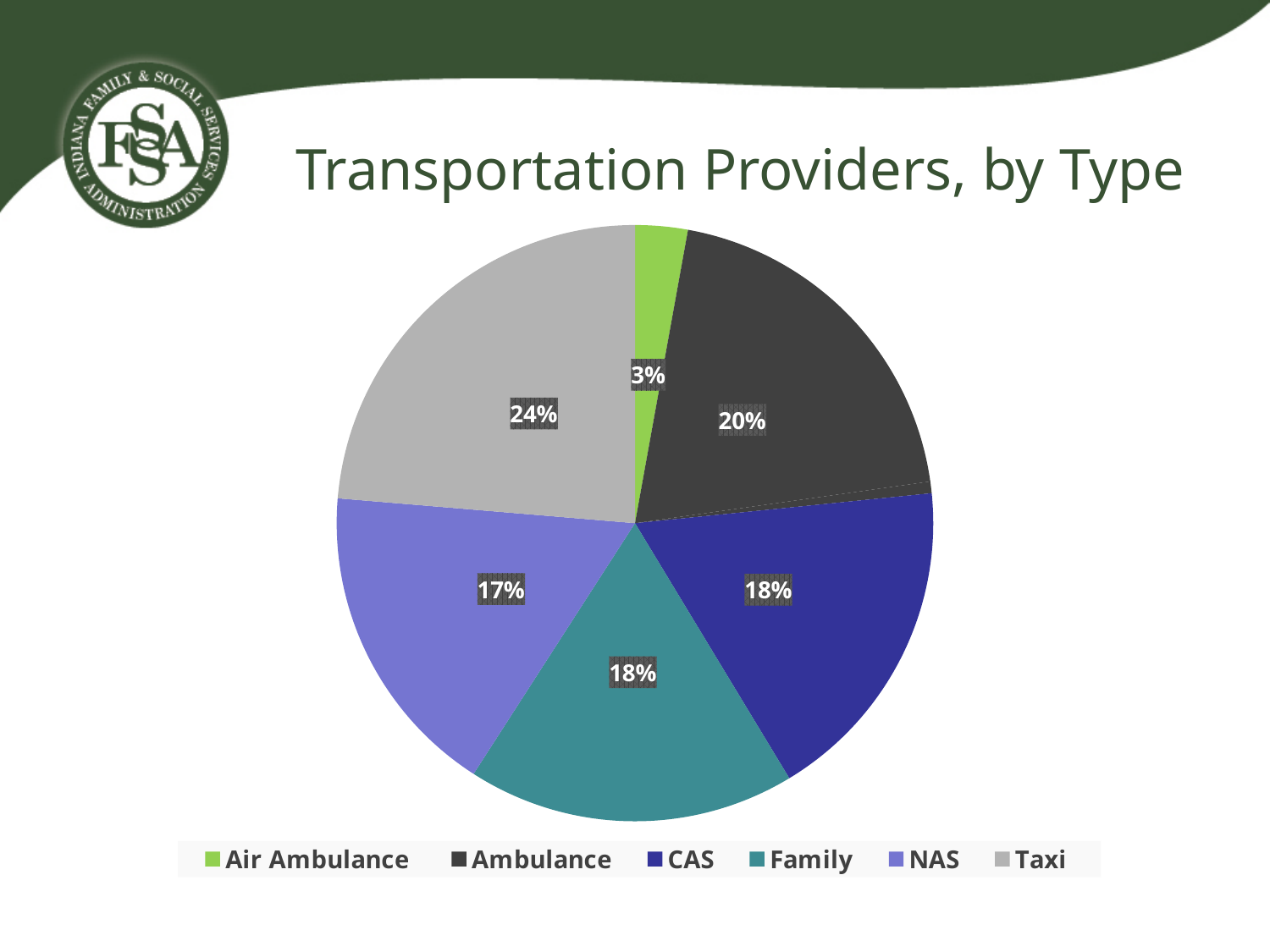
Which provider type has the smallest share of the pie? Air Ambulance What is the difference in percentage points between the Taxi share and the Ambulance share? 4 percentage points What share of transportation providers are NAS? 17% Which provider type has the largest share of the pie? Taxi Which has a larger share, NAS or Ambulance? Ambulance How many provider types are shown in the pie chart? 6 What is the title of the chart? Transportation Providers, by Type What share of transportation providers are Air Ambulance? 3% What share of transportation providers are Taxi? 24% What share of transportation providers are Family? 18% What share of transportation providers are Ambulance? 20% What type of chart is shown on the slide? pie chart